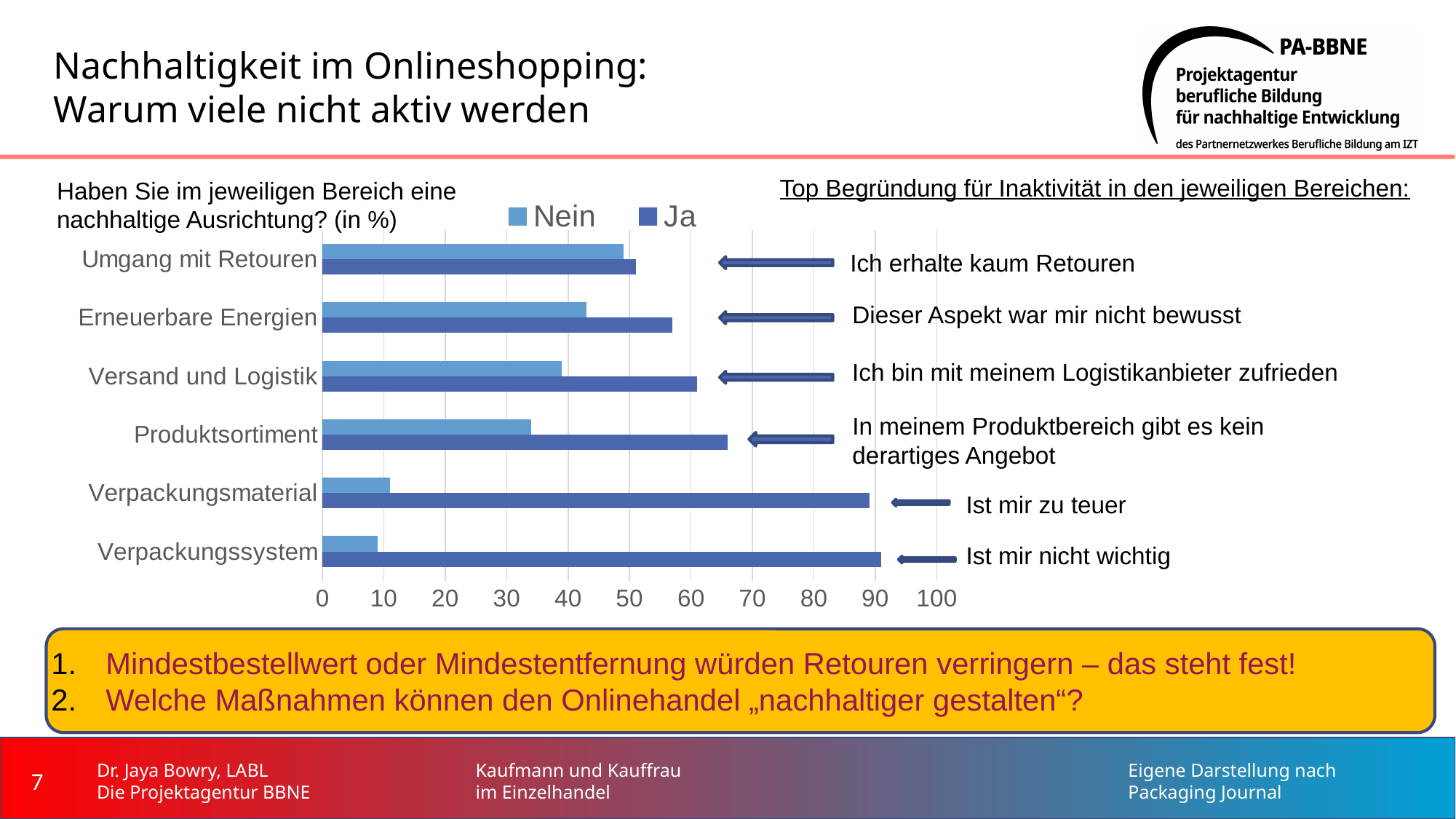
Is the Ja value for Verpackungsmaterial greater or less than 80? greater Which category has the lowest value for the Ja series? Umgang mit Retouren For Produktsortiment, which is larger: the Ja value or the Nein value? Ja How many categories does the chart show? 6 Which two series are listed in the chart legend? Nein and Ja Which is larger: the Nein value for Verpackungsmaterial or the Nein value for Produktsortiment? Produktsortiment Is the Nein value for Produktsortiment greater or less than 40? less How many series does the legend list? 2 Which category has the highest value for the Nein series? Umgang mit Retouren Is the Ja value for Versand und Logistik greater or less than 50? greater What kind of chart is shown on the slide? bar chart